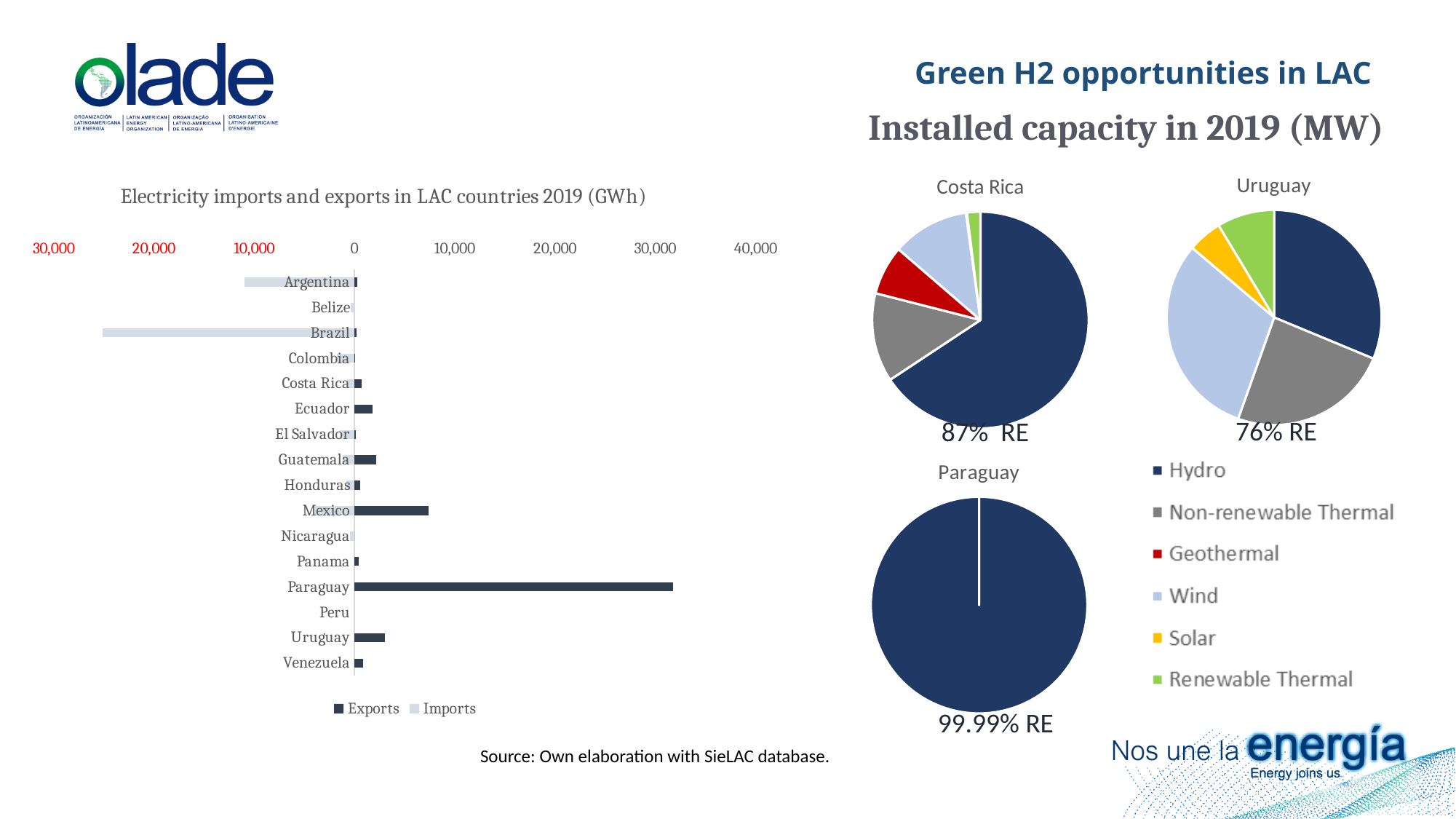
What kind of charts are used to show installed capacity in 2019 for Costa Rica, Uruguay and Paraguay? pie charts In the installed capacity pie charts, what share of Costa Rica's installed capacity is renewable (RE)? 87% RE In the 'Electricity imports and exports in LAC countries 2019 (GWh)' chart, are Mexico's exports greater or less than 10,000? less In the 'Electricity imports and exports in LAC countries 2019 (GWh)' chart, how many countries are listed? 16 What kind of chart is the 'Electricity imports and exports in LAC countries 2019 (GWh)' chart? bar chart How many series does the legend of the 'Electricity imports and exports in LAC countries 2019 (GWh)' chart list? 2 In the 'Electricity imports and exports in LAC countries 2019 (GWh)' chart, which country has larger exports, Paraguay or Mexico? Paraguay In the 'Electricity imports and exports in LAC countries 2019 (GWh)' chart, which country has the highest exports? Paraguay How many entries does the legend of the installed capacity pie charts list? 6 In the installed capacity pie charts, what share of Paraguay's installed capacity is renewable (RE)? 99.99% RE In the 'Electricity imports and exports in LAC countries 2019 (GWh)' chart, which country has the highest imports? Brazil In the 'Electricity imports and exports in LAC countries 2019 (GWh)' chart, are Brazil's imports greater or less than 20,000? greater